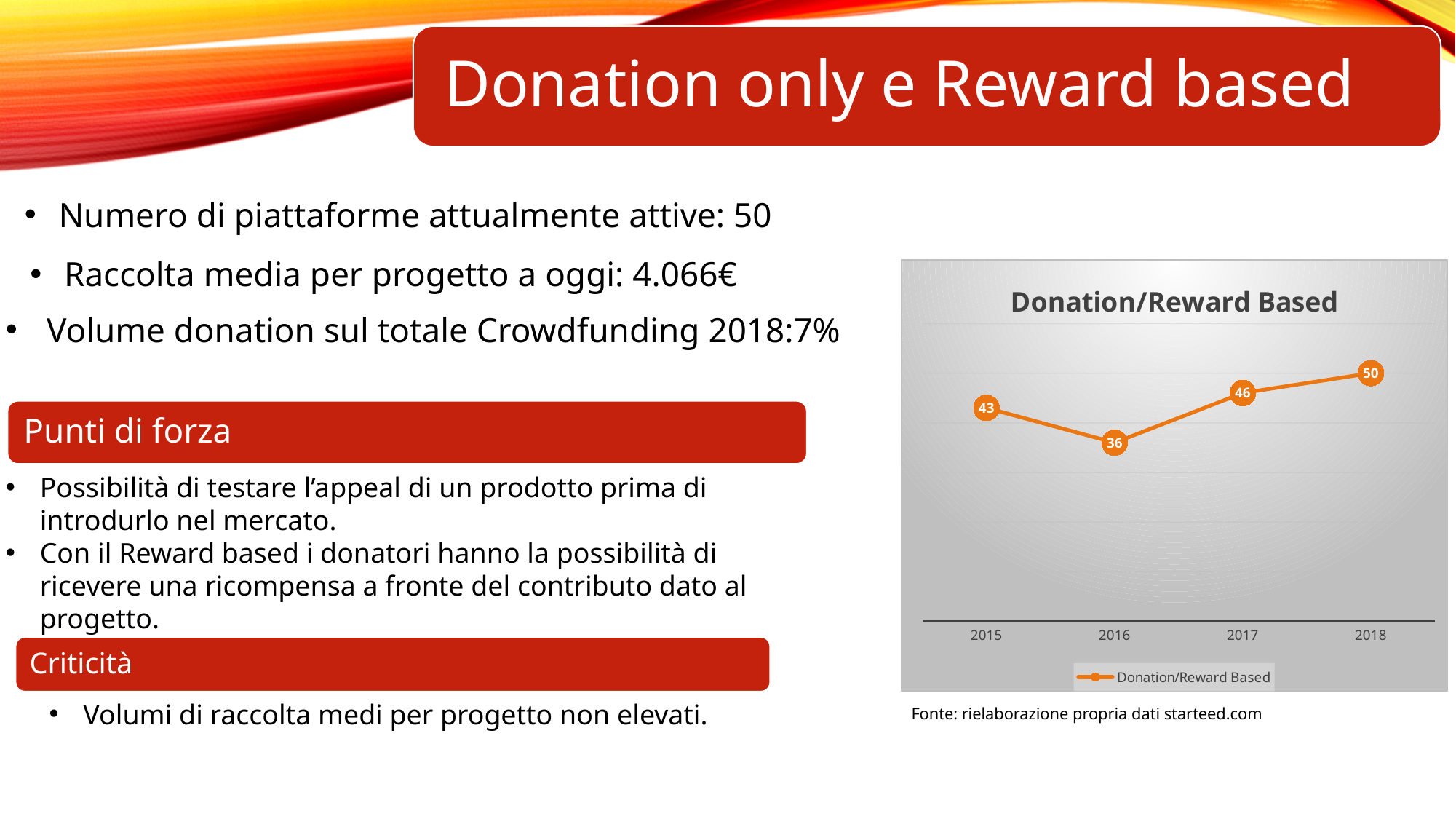
What kind of chart is the Donation/Reward Based chart? Line chart What is the value for 2015 in the Donation/Reward Based chart? 43 How many years are plotted in the Donation/Reward Based chart? 4 Do the values in the Donation/Reward Based chart rise or fall from 2016 to 2018? Rise What is the value for 2018 in the Donation/Reward Based chart? 50 How many series does the legend of the Donation/Reward Based chart list? 1 What is the value for 2017 in the Donation/Reward Based chart? 46 Which year has the lowest value in the Donation/Reward Based chart? 2016 What is the value for 2016 in the Donation/Reward Based chart? 36 Which is larger in the Donation/Reward Based chart, the value for 2015 or the value for 2017? 2017 What is the difference between the 2018 and 2016 values in the Donation/Reward Based chart? 14 Which year has the highest value in the Donation/Reward Based chart? 2018